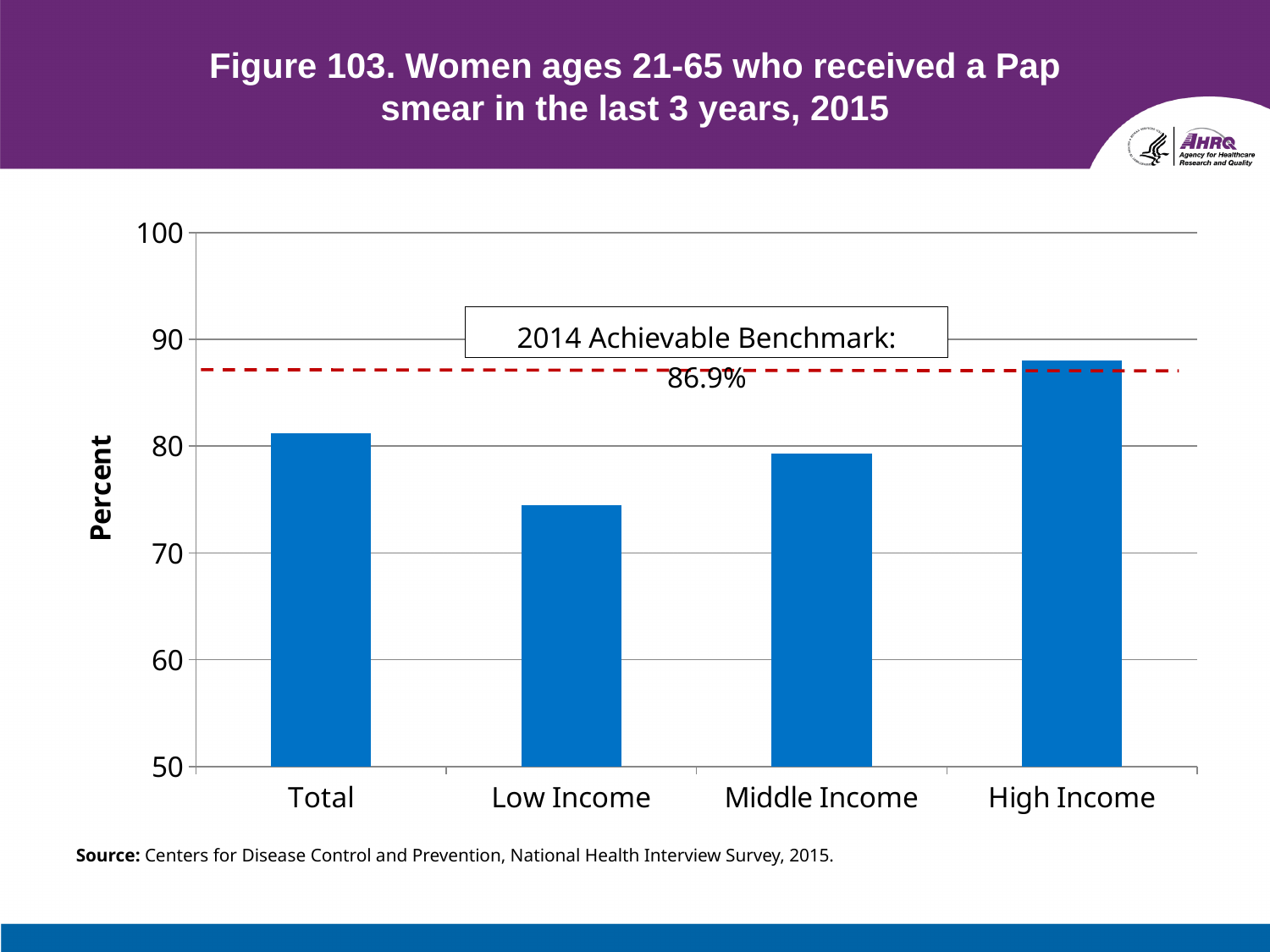
Is the value for Middle Income greater or less than 70? greater Which category has the lowest value? Low Income How many categories are shown on the x axis? 4 Is the value for High Income greater or less than 80? greater Which category has the highest value? High Income What is the label on the y axis? Percent Is the value for Low Income greater or less than 80? less What kind of chart is shown on the slide? bar chart Which is larger, the value for Low Income or the value for High Income? High Income What is the 2014 Achievable Benchmark shown by the dashed line? 86.9% Which is larger, the value for Total or the value for Middle Income? Total